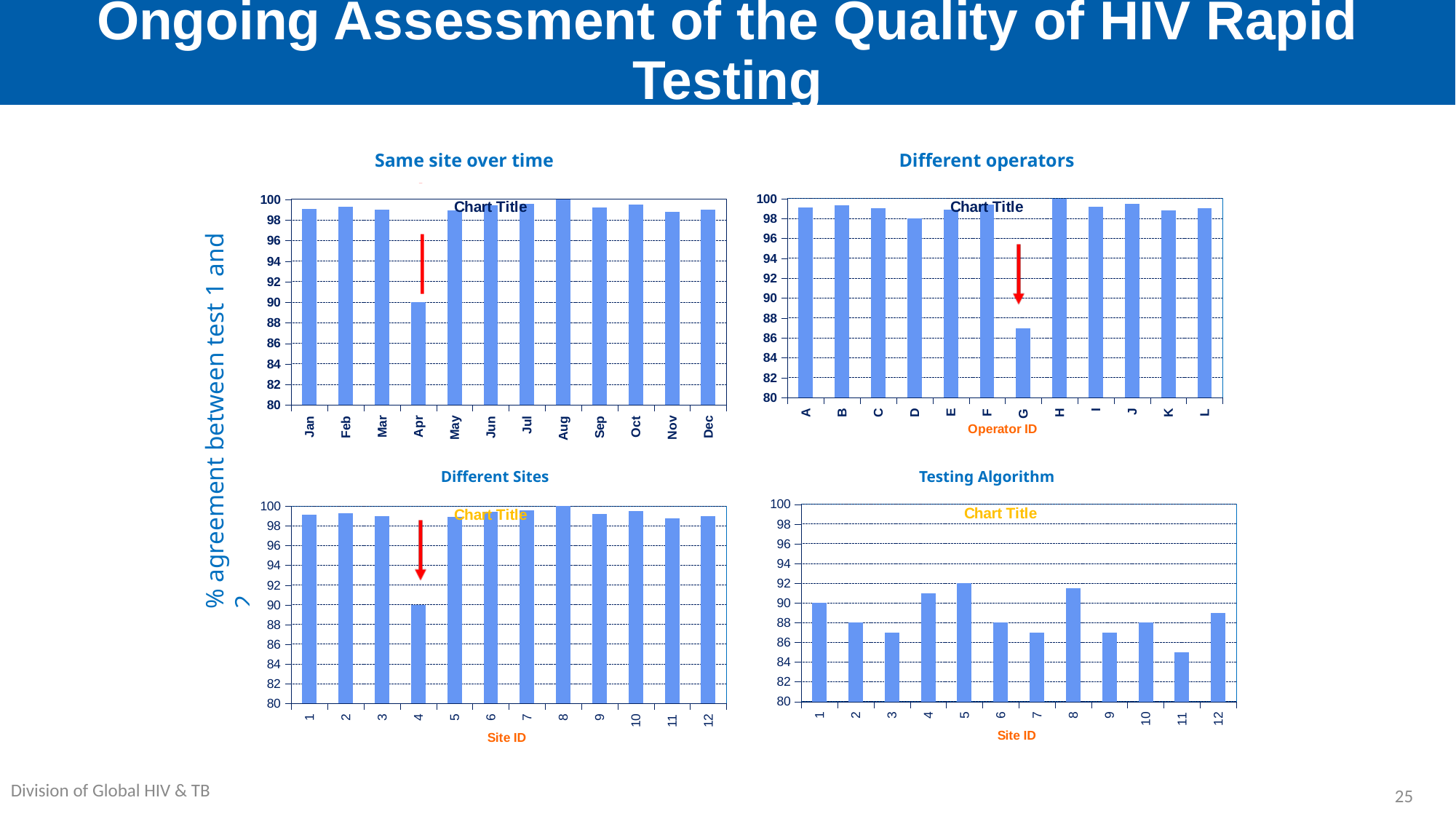
In the 'Same site over time' chart, is the value for Apr greater or less than 96? less In the 'Different operators' chart, is the value for operator G greater or less than 90? less In the 'Testing Algorithm' chart, is the value for site 11 greater or less than 86? less In the 'Same site over time' chart, which month has the lowest value? Apr In the 'Same site over time' chart, how many months are shown on the x axis? 12 In the 'Testing Algorithm' chart, which site has the highest value? 5 In the 'Different operators' chart, which is larger, the value for operator D or operator G? D In the 'Different Sites' chart, which site has the lowest value? 4 In the 'Testing Algorithm' chart, which site has the lowest value? 11 What type of chart is the 'Testing Algorithm' chart? bar chart